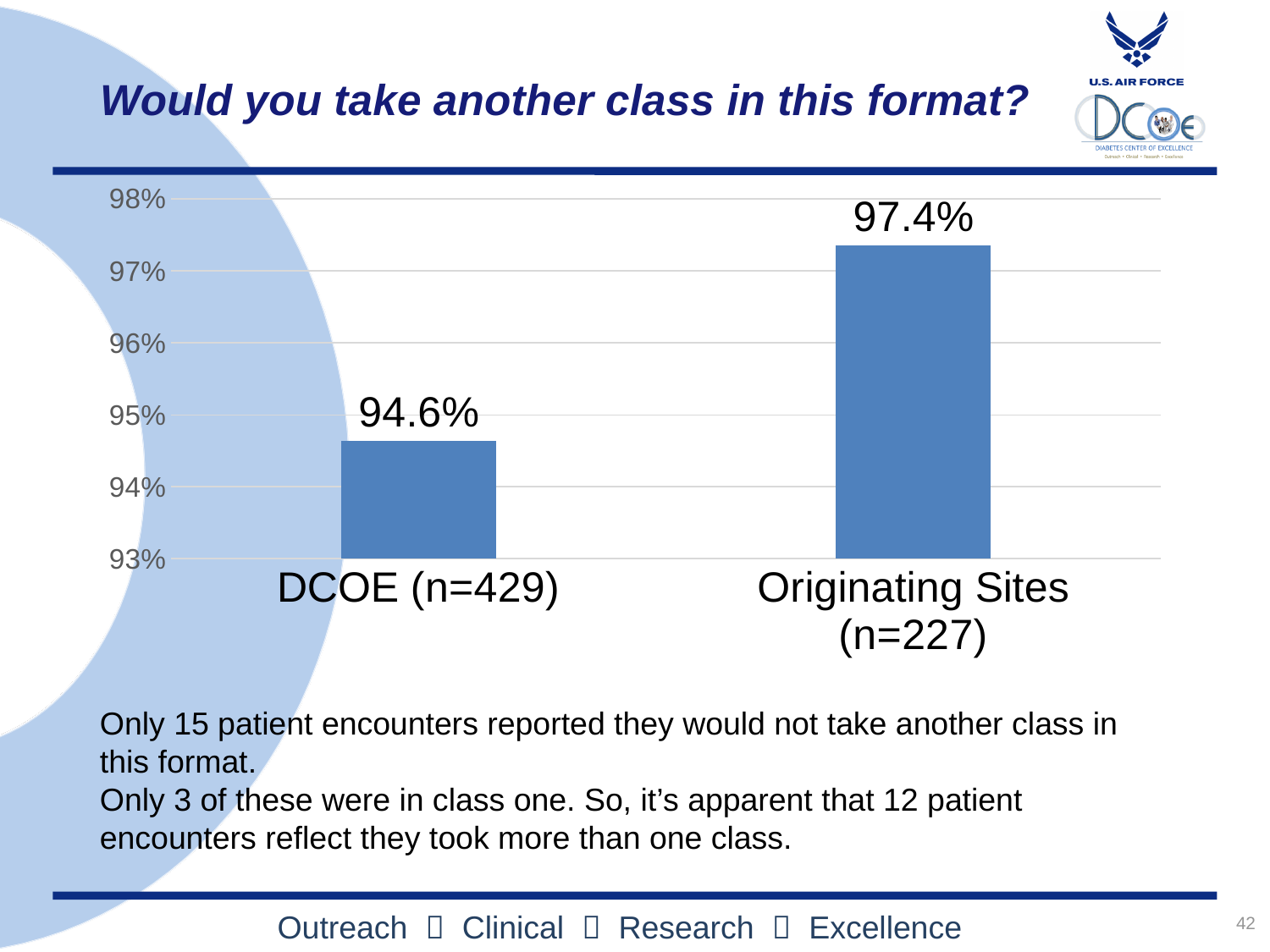
What kind of chart is shown on the slide? bar chart Which is larger, the value for DCOE (n=429) or the value for Originating Sites (n=227)? Originating Sites (n=227) Which category has the lowest value? DCOE (n=429) What is the value for DCOE (n=429)? 94.6% What is the title of the slide containing the chart? Would you take another class in this format? Which category has the highest value? Originating Sites (n=227) What is the value for Originating Sites (n=227)? 97.4% Is the value for Originating Sites (n=227) greater or less than 97%? greater What is the lowest value shown on the vertical axis? 93% What is the difference between the values for Originating Sites (n=227) and DCOE (n=429)? 2.8% Is the value for DCOE (n=429) greater or less than 95%? less How many categories are shown in the chart? 2